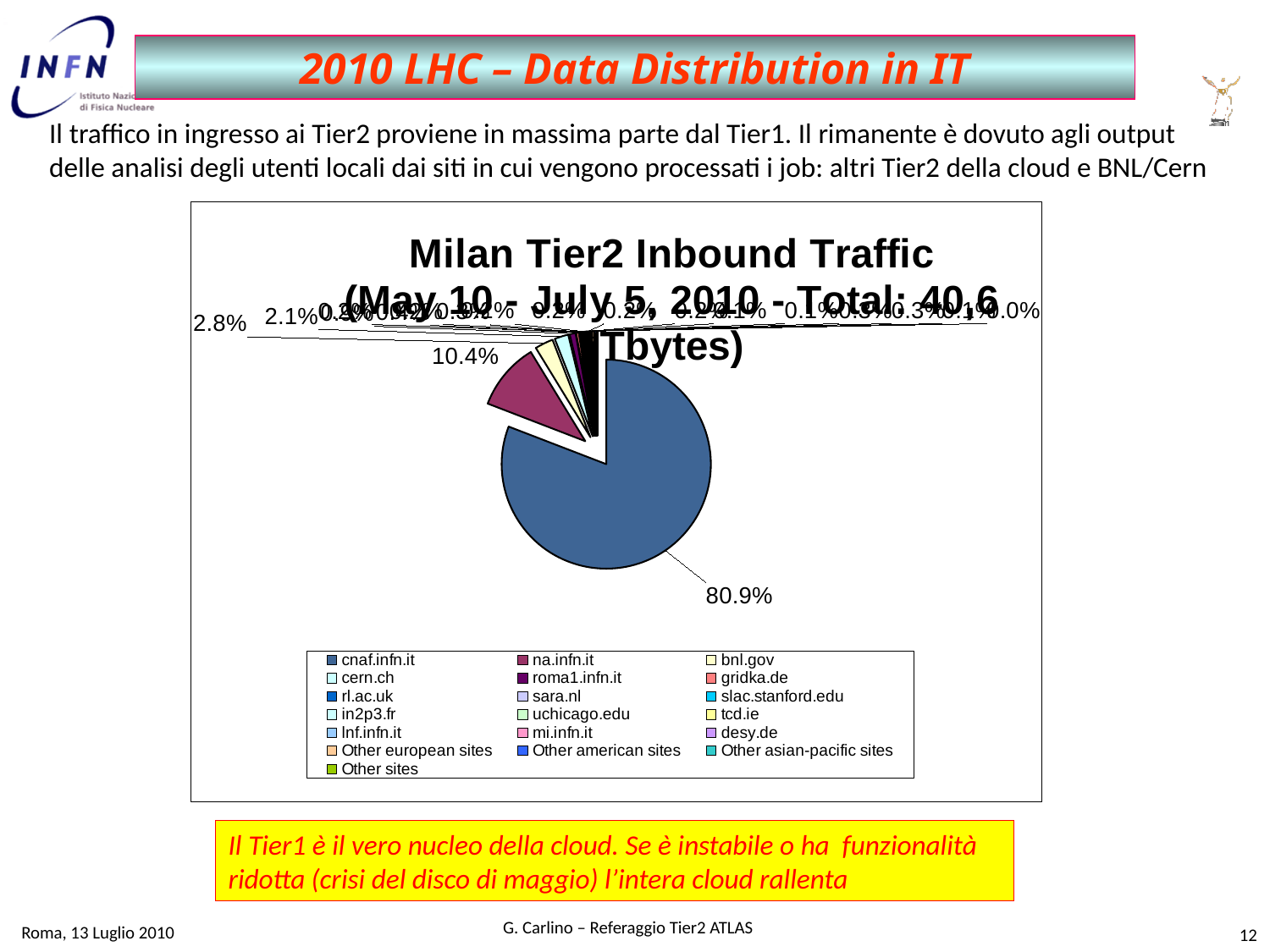
What is the difference in percentage points between the largest slice (80.9%) and the second-largest slice (10.4%)? 70.5 What total traffic volume is stated in the chart title? 40,6 Tbytes Is the share of the largest slice greater or less than 50%? greater Which is larger, the slice labelled 2.8% or the slice labelled 2.1%? 2.8% What share of the pie does the largest slice represent? 80.9% How many entries does the legend list? 19 What is the share for cnaf.infn.it? 80.9% What kind of chart is shown on the slide? pie chart What share of the pie does the second-largest slice represent? 10.4% Which is larger, the slice labelled 80.9% or the slice labelled 10.4%? 80.9% Which site accounts for the largest slice of the pie? cnaf.infn.it What is the title of the chart? Milan Tier2 Inbound Traffic (May 10 - July 5, 2010 - Total: 40,6 Tbytes)